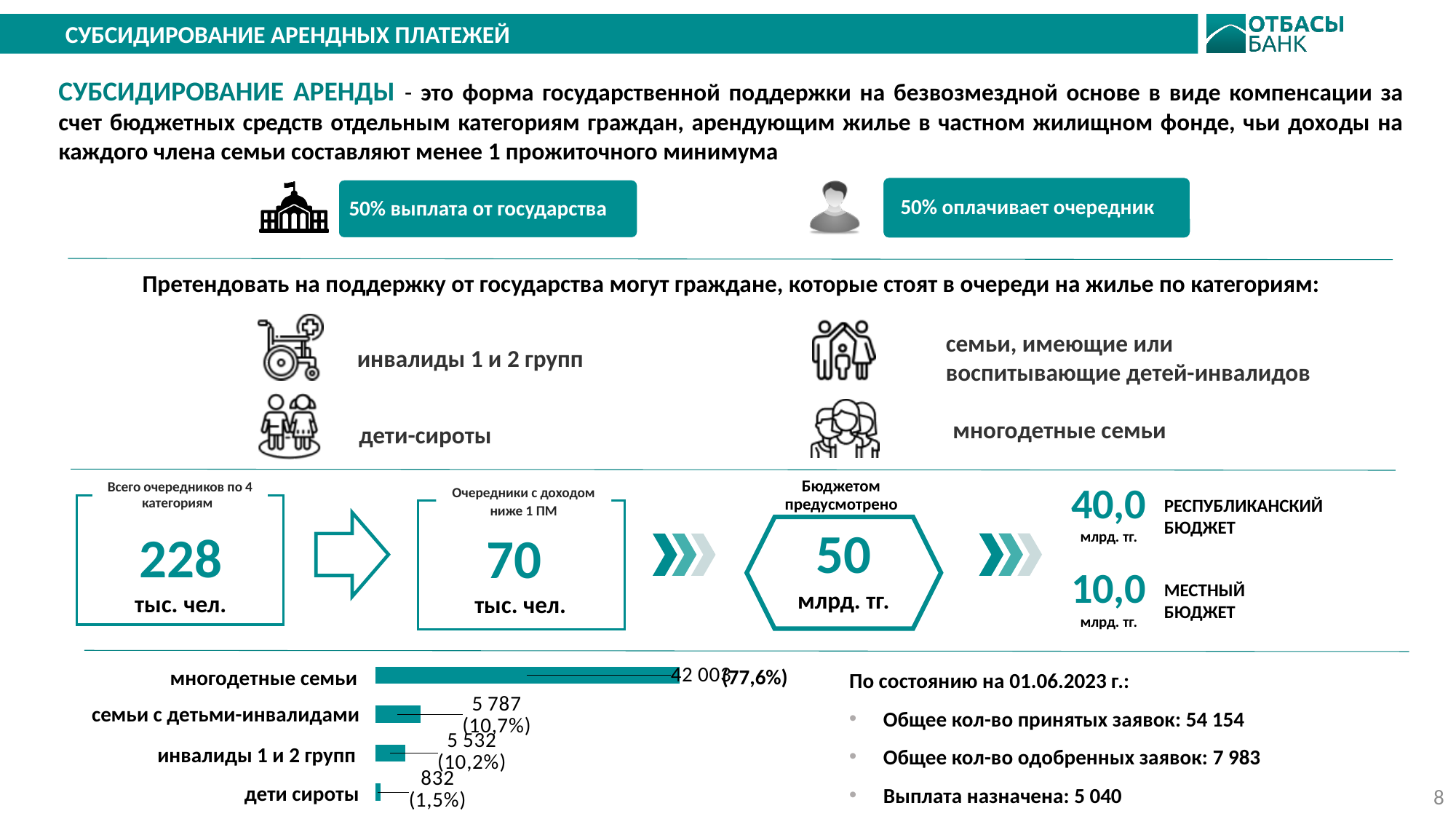
Which category has the lowest value in the bar chart? дети сироты What kind of chart is shown at the bottom left of the slide? bar chart In the bar chart, what percentage is shown for дети сироты? 1,5% In the bar chart, what percentage is shown for семьи с детьми-инвалидами? 10,7% Which category has the highest value in the bar chart? многодетные семьи In the bar chart, what is the difference between the values for семьи с детьми-инвалидами and инвалиды 1 и 2 групп? 255 In the bar chart, what is the value for инвалиды 1 и 2 групп? 5 532 How many categories are shown in the bar chart at the bottom of the slide? 4 In the bar chart, what is the value for семьи с детьми-инвалидами? 5 787 In the bar chart, what percentage is shown for многодетные семьи? 77,6% In the bar chart, which is larger: the value for семьи с детьми-инвалидами or the value for инвалиды 1 и 2 групп? семьи с детьми-инвалидами In the bar chart, what is the value for дети сироты? 832